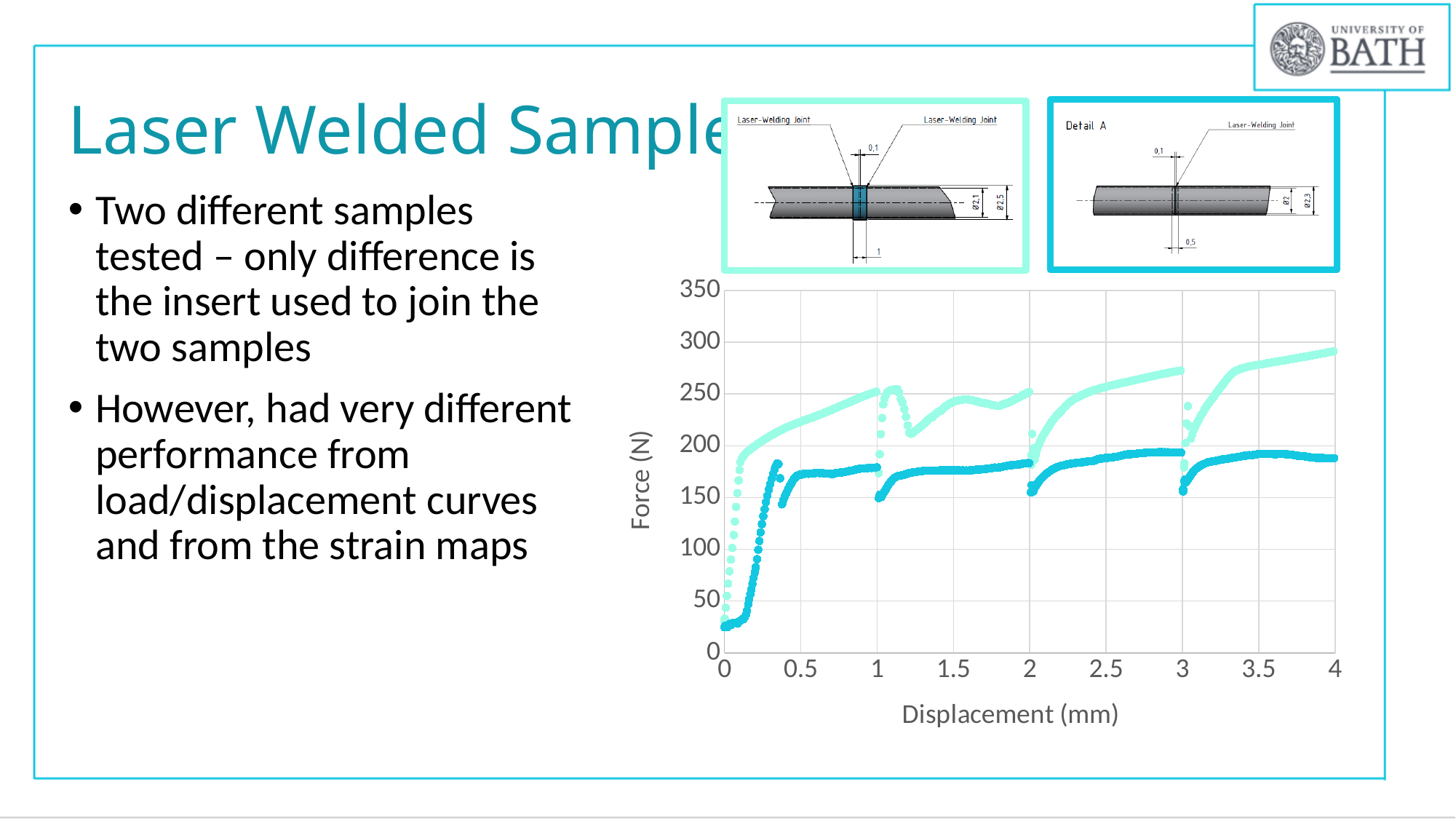
What is the highest value shown on the Force (N) axis? 350 What is the label of the horizontal axis of the chart? Displacement (mm) Does the force for the light cyan series generally rise or fall as displacement increases from 1.5 mm to 4 mm? rise Which series reaches a higher force at a displacement of 3.5 mm, the light cyan series or the dark cyan series? the light cyan series Is the force for the light cyan series at a displacement of 4 mm greater or less than 250 N? greater What is the label of the vertical axis of the chart? Force (N) Is the force for the dark cyan series at a displacement of 4 mm greater or less than 200 N? less What kind of chart is shown on the slide? scatter chart How many data series are plotted on the chart? 2 Is the force for the light cyan series at a displacement of 0.5 mm greater or less than 200 N? greater